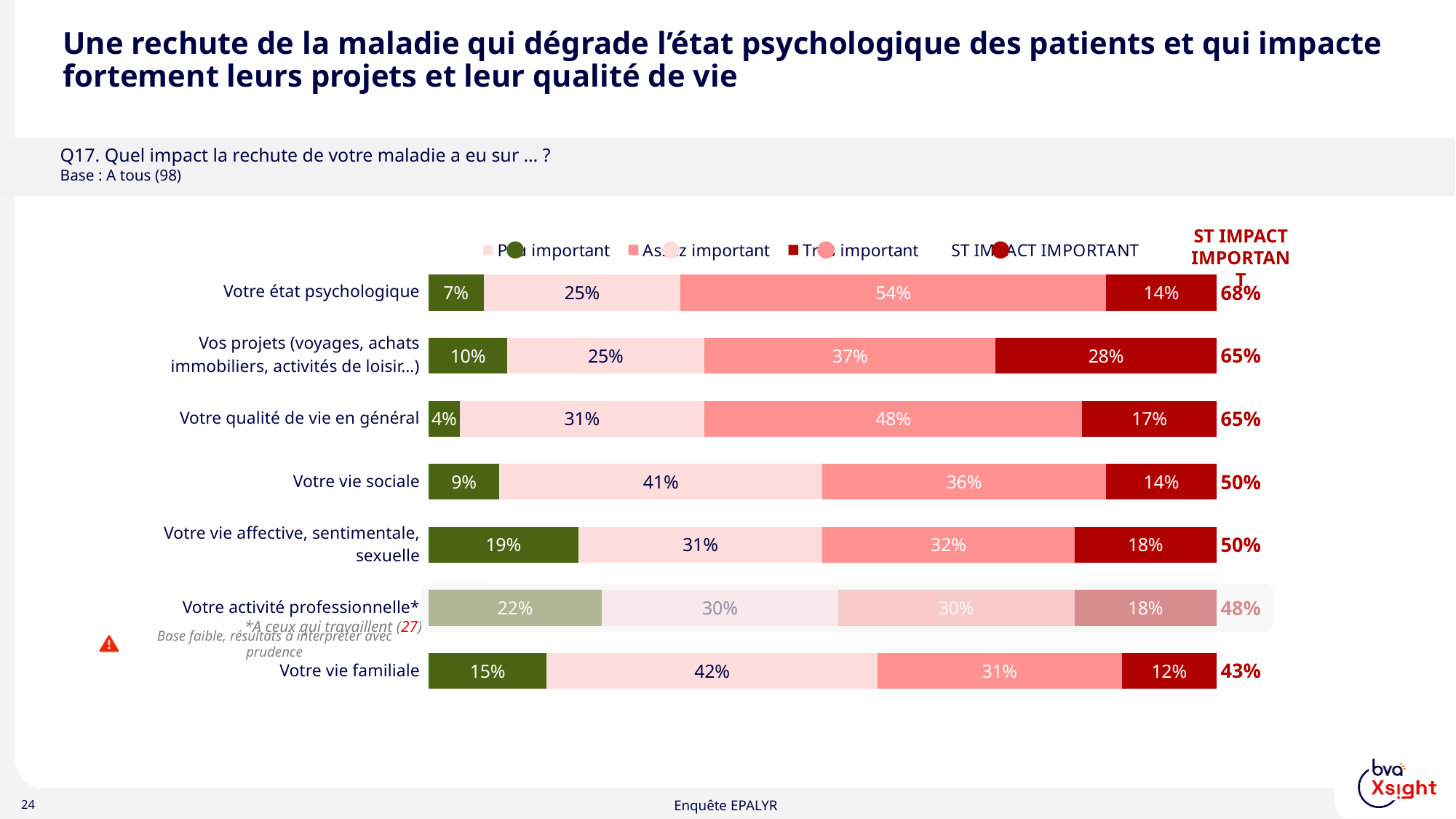
What is the value of the light pink segment for "Votre vie sociale"? 41% How many categories (bars) are shown in the chart? 7 What is the base (number of respondents) for the "Votre activité professionnelle*" bar? 27 Which has a larger ST IMPACT IMPORTANT value: "Vos projets (voyages, achats immobiliers, activités de loisir...)" or "Votre vie sociale"? Vos projets (voyages, achats immobiliers, activités de loisir...) What is the total of all segments in the "Votre vie familiale" bar? 100% Which category has the lowest ST IMPACT IMPORTANT value? Votre vie familiale What is the difference between the ST IMPACT IMPORTANT values for "Votre état psychologique" and "Votre vie familiale"? 25 percentage points Which category has the highest ST IMPACT IMPORTANT value? Votre état psychologique What kind of chart is shown on the slide? Stacked horizontal bar chart What is the ST IMPACT IMPORTANT value for "Votre vie sociale"? 50% What is the value of the dark red segment for "Vos projets (voyages, achats immobiliers, activités de loisir...)"? 28% What is the value of the dark green segment for "Votre vie affective, sentimentale, sexuelle"? 19%